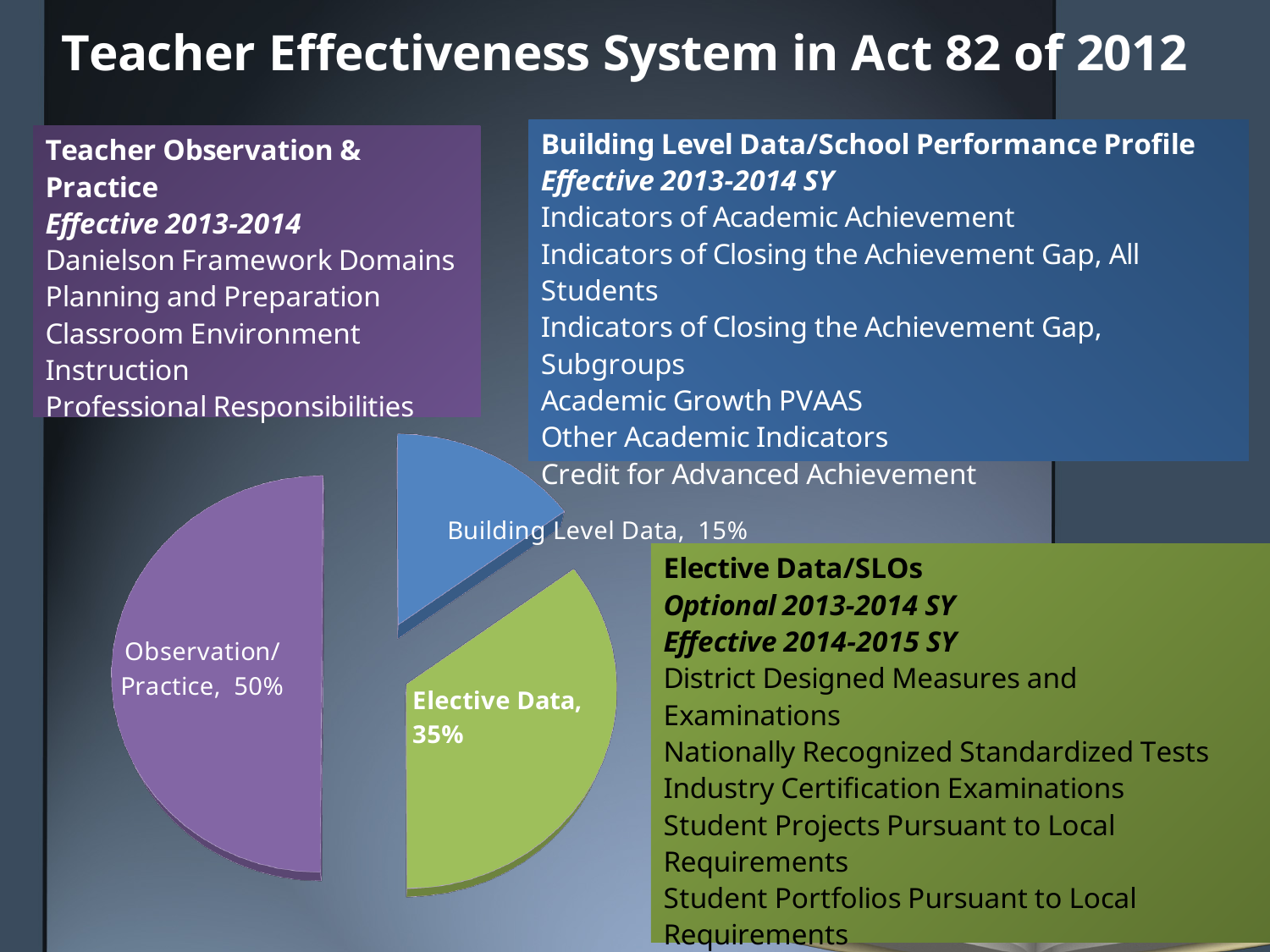
Which is larger, the Elective Data slice or the Building Level Data slice? Elective Data What colour is the Observation/Practice slice? purple What is the value shown for Elective Data? 35% Which slice of the pie is the largest? Observation/Practice What kind of chart is shown on the slide? pie chart What is the difference between the Observation/Practice share and the Elective Data share? 15% What colour is the Building Level Data slice? blue What is the difference between the Elective Data share and the Building Level Data share? 20% How many slices does the pie chart have? 3 What is the value shown for Building Level Data? 15% What share of the pie does Observation/Practice represent? 50% Which slice of the pie is the smallest? Building Level Data